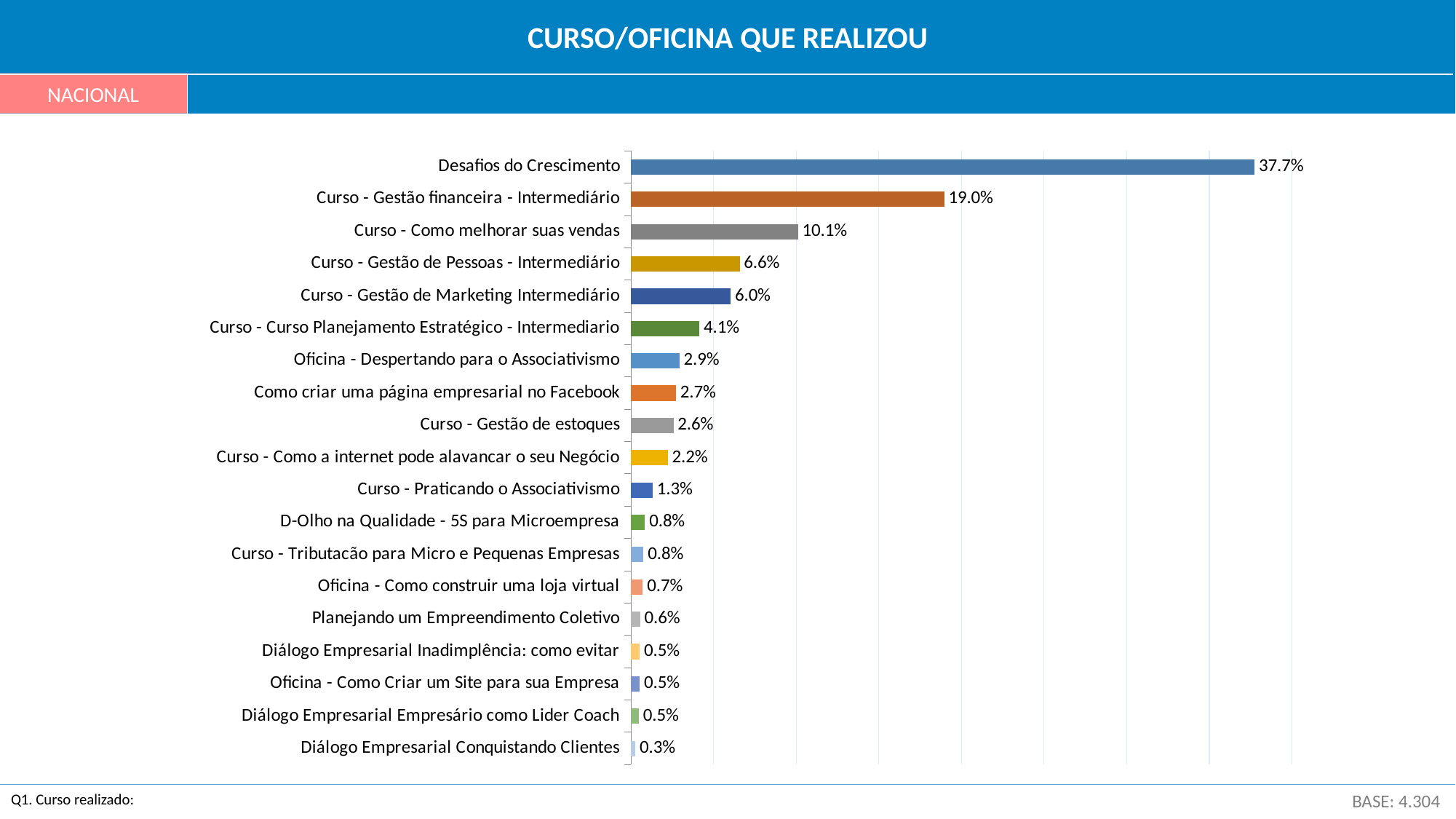
What is the difference between Curso - Como melhorar suas vendas and Curso - Gestão de Pessoas - Intermediário? 3.5% Which category has the highest value? Desafios do Crescimento What is the title of the slide? CURSO/OFICINA QUE REALIZOU What is the value for Oficina - Como construir uma loja virtual? 0.7% What kind of chart is shown on the slide? Bar chart What is the value for Curso - Gestão de Marketing Intermediário? 6.0% How many categories are shown in the chart? 19 What is the value for Desafios do Crescimento? 37.7% What is the value for Curso - Gestão de estoques? 2.6% What is the difference between Desafios do Crescimento and Curso - Gestão financeira - Intermediário? 18.7% Which is larger: Oficina - Despertando para o Associativismo or Curso - Como a internet pode alavancar o seu Negócio? Oficina - Despertando para o Associativismo Which category has the lowest value? Diálogo Empresarial Conquistando Clientes